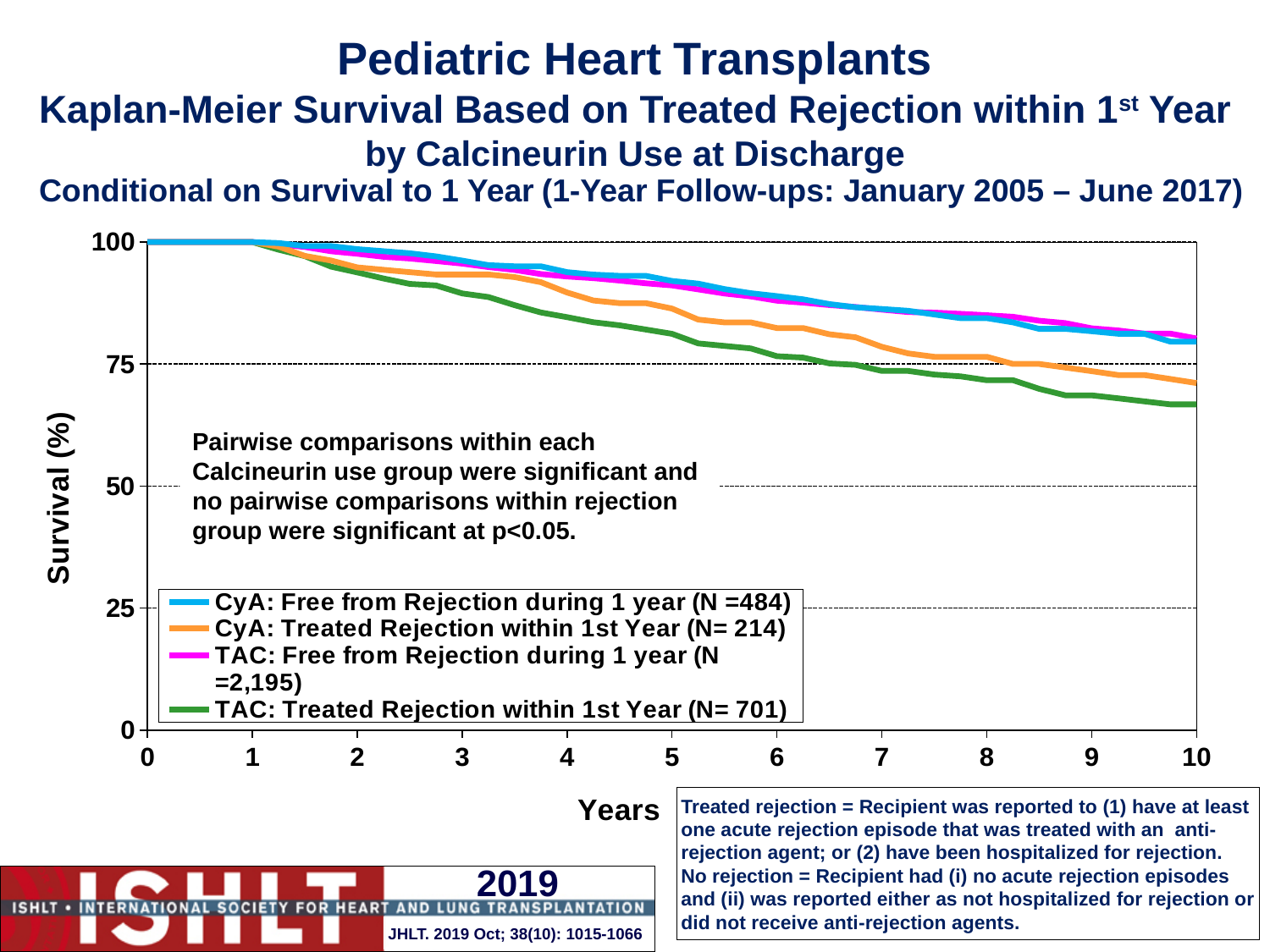
Is the survival value for CyA: Free from Rejection during 1 year at 10 years greater or less than 75? greater Is the survival value for CyA: Treated Rejection within 1st Year at 10 years greater or less than 75? less What kind of chart is shown on the slide? line chart Is the survival value for TAC: Treated Rejection within 1st Year at 5 years greater or less than 75? greater Which series has the lowest survival at 10 years? TAC: Treated Rejection within 1st Year (N= 701) What is the label of the y axis? Survival (%) At 8 years, is survival higher for CyA: Free from Rejection during 1 year or for TAC: Treated Rejection within 1st Year? CyA: Free from Rejection during 1 year How many series does the legend list? 4 Do the survival curves rise or fall as the years increase along the x axis? fall At 10 years, is survival higher for CyA: Free from Rejection during 1 year or for TAC: Treated Rejection within 1st Year? CyA: Free from Rejection during 1 year How many tick marks are labelled on the x axis (Years)? 11